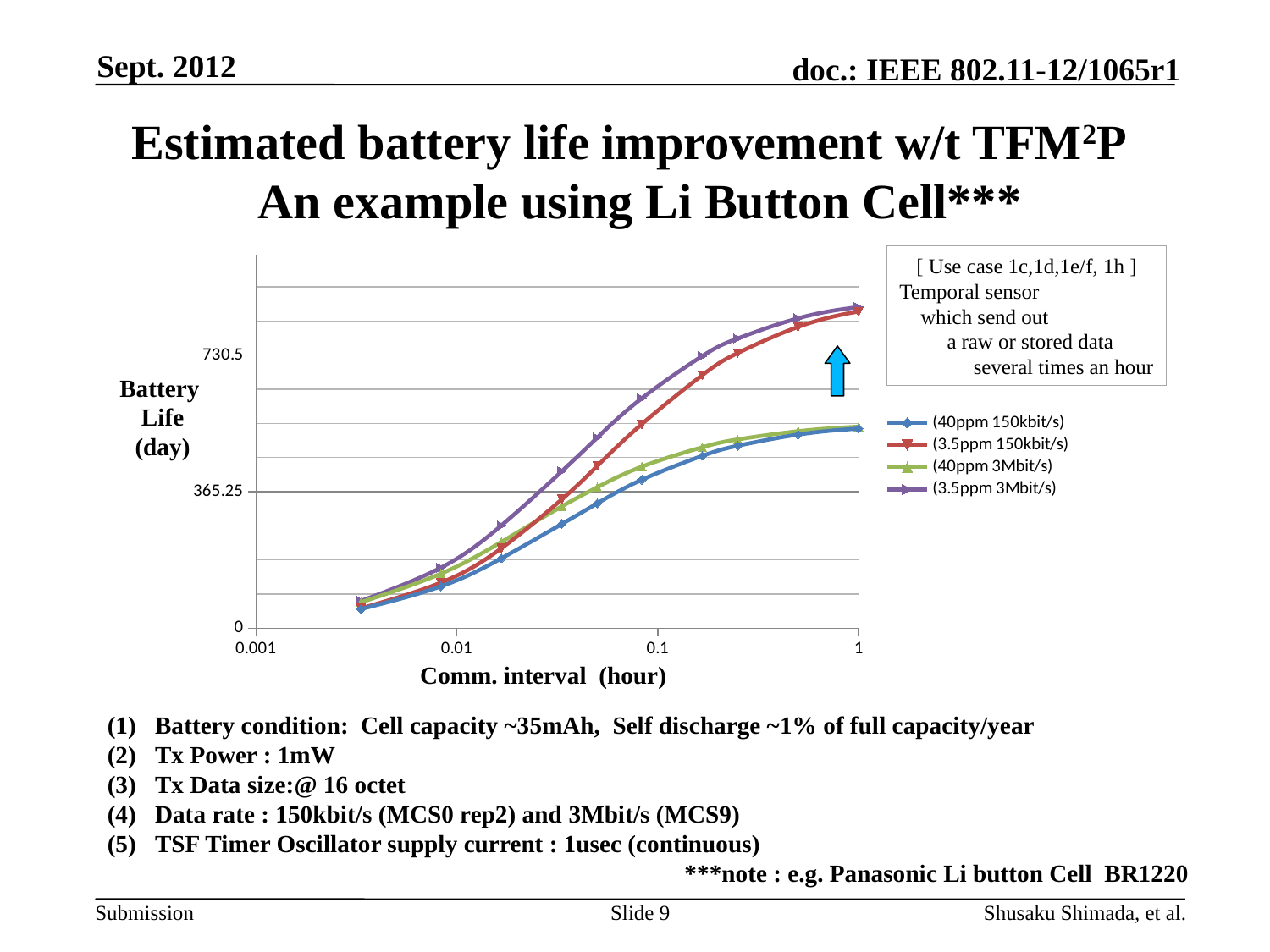
What kind of chart is shown on the slide? line chart At a communication interval of 1 hour, is the battery life for (40ppm 150kbit/s) greater or less than 730.5 days? less At a communication interval of 1 hour, is the battery life for (3.5ppm 3Mbit/s) greater or less than 730.5 days? greater At a communication interval of 0.01 hour, is the battery life for (3.5ppm 3Mbit/s) greater or less than 365.25 days? less Do the battery life values rise or fall as the communication interval increases along the x axis? rise At a communication interval of 0.1 hour, which has the larger battery life: (3.5ppm 150kbit/s) or (40ppm 150kbit/s)? (3.5ppm 150kbit/s) How many series does the chart legend list? 4 Which series has the highest battery life at a communication interval of 1 hour? (3.5ppm 3Mbit/s) What is the label of the chart's horizontal axis? Comm. interval (hour) What is the label of the chart's vertical axis? Battery Life (day) At a communication interval of 1 hour, which has the larger battery life: (3.5ppm 3Mbit/s) or (40ppm 150kbit/s)? (3.5ppm 3Mbit/s)